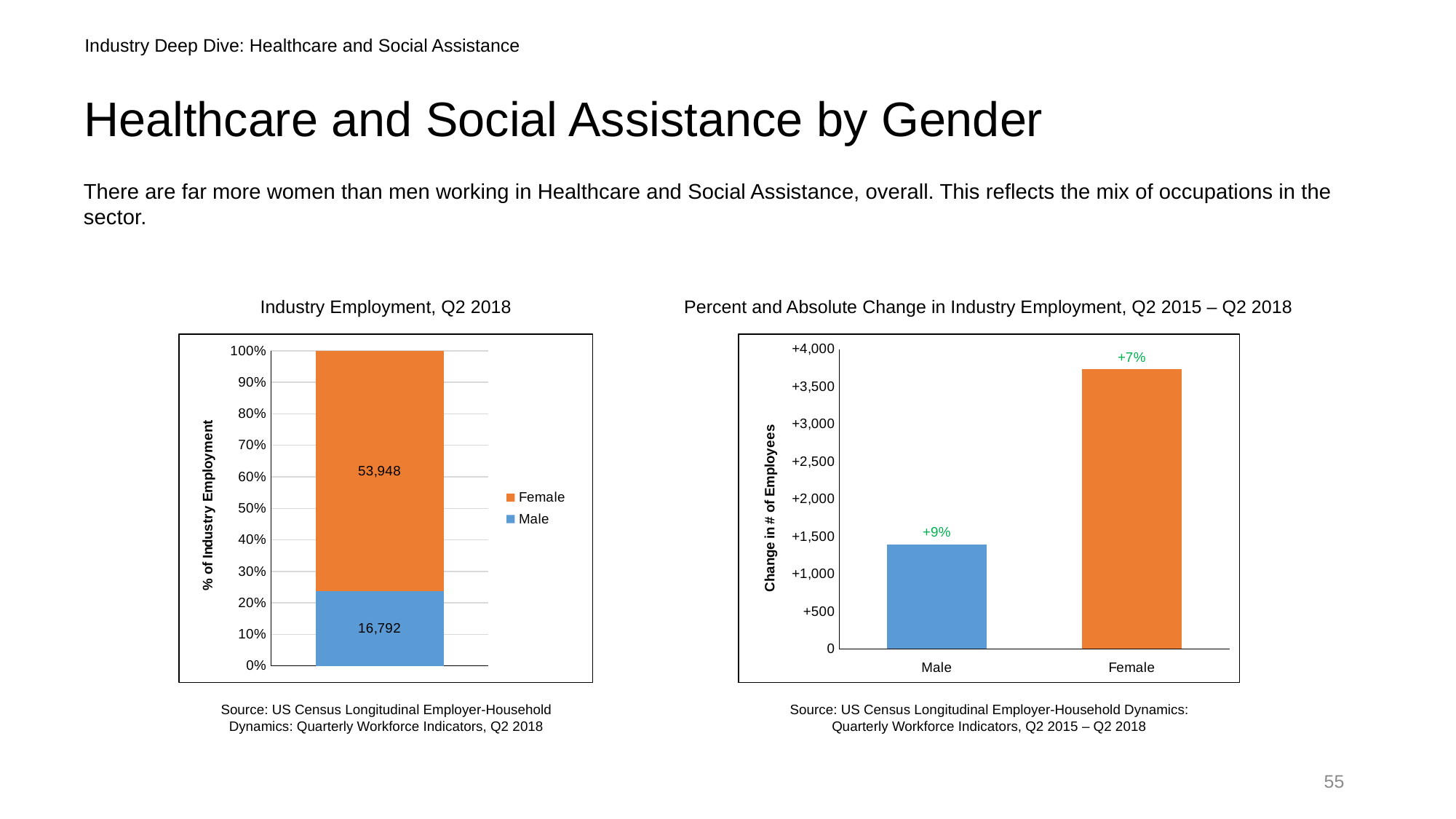
In the 'Percent and Absolute Change in Industry Employment, Q2 2015 – Q2 2018' chart, is the change in number of employees for Male greater or less than +1,500? less In the 'Industry Employment, Q2 2018' chart, which series is shown in orange? Female What kind of chart is the 'Percent and Absolute Change in Industry Employment, Q2 2015 – Q2 2018' chart? Bar chart In the 'Industry Employment, Q2 2018' chart, what is the value shown for Male? 16,792 In the 'Industry Employment, Q2 2018' chart, what is the value shown for Female? 53,948 In the 'Percent and Absolute Change in Industry Employment, Q2 2015 – Q2 2018' chart, what percent change is labelled for Male? +9% In the 'Industry Employment, Q2 2018' chart, how many series does the legend list? 2 In the 'Percent and Absolute Change in Industry Employment, Q2 2015 – Q2 2018' chart, which category has the taller bar? Female In the 'Industry Employment, Q2 2018' chart, what is the total of the two stacked segments? 70,740 In the 'Percent and Absolute Change in Industry Employment, Q2 2015 – Q2 2018' chart, what percent change is labelled for Female? +7% In the 'Industry Employment, Q2 2018' chart, what is the difference between the Female and Male values? 37,156 In the 'Percent and Absolute Change in Industry Employment, Q2 2015 – Q2 2018' chart, is the change in number of employees for Female greater or less than +3,500? greater